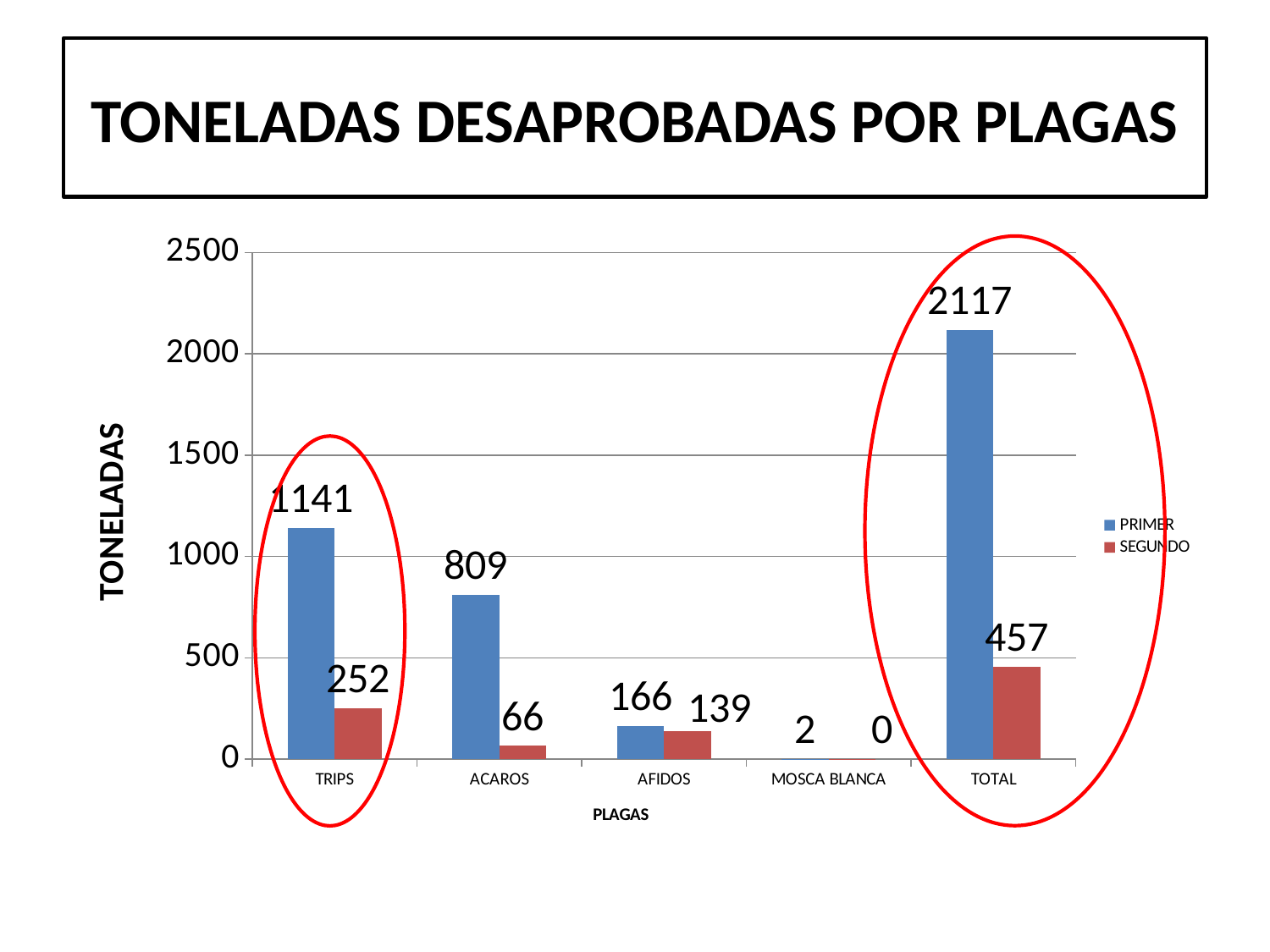
Which is larger for AFIDOS, the PRIMER value or the SEGUNDO value? PRIMER What is the SEGUNDO value for MOSCA BLANCA? 0 How many categories are shown on the x axis? 5 Excluding TOTAL, which pest has the highest PRIMER value? TRIPS What is the SEGUNDO value for ACAROS? 66 What is the PRIMER value for TOTAL? 2117 What is the PRIMER value for TRIPS? 1141 What is the difference between the PRIMER and SEGUNDO values for TRIPS? 889 What is the title of the slide? TONELADAS DESAPROBADAS POR PLAGAS What kind of chart is shown on the slide? Bar chart Which pest has the lowest SEGUNDO value? MOSCA BLANCA How many series does the legend list? 2